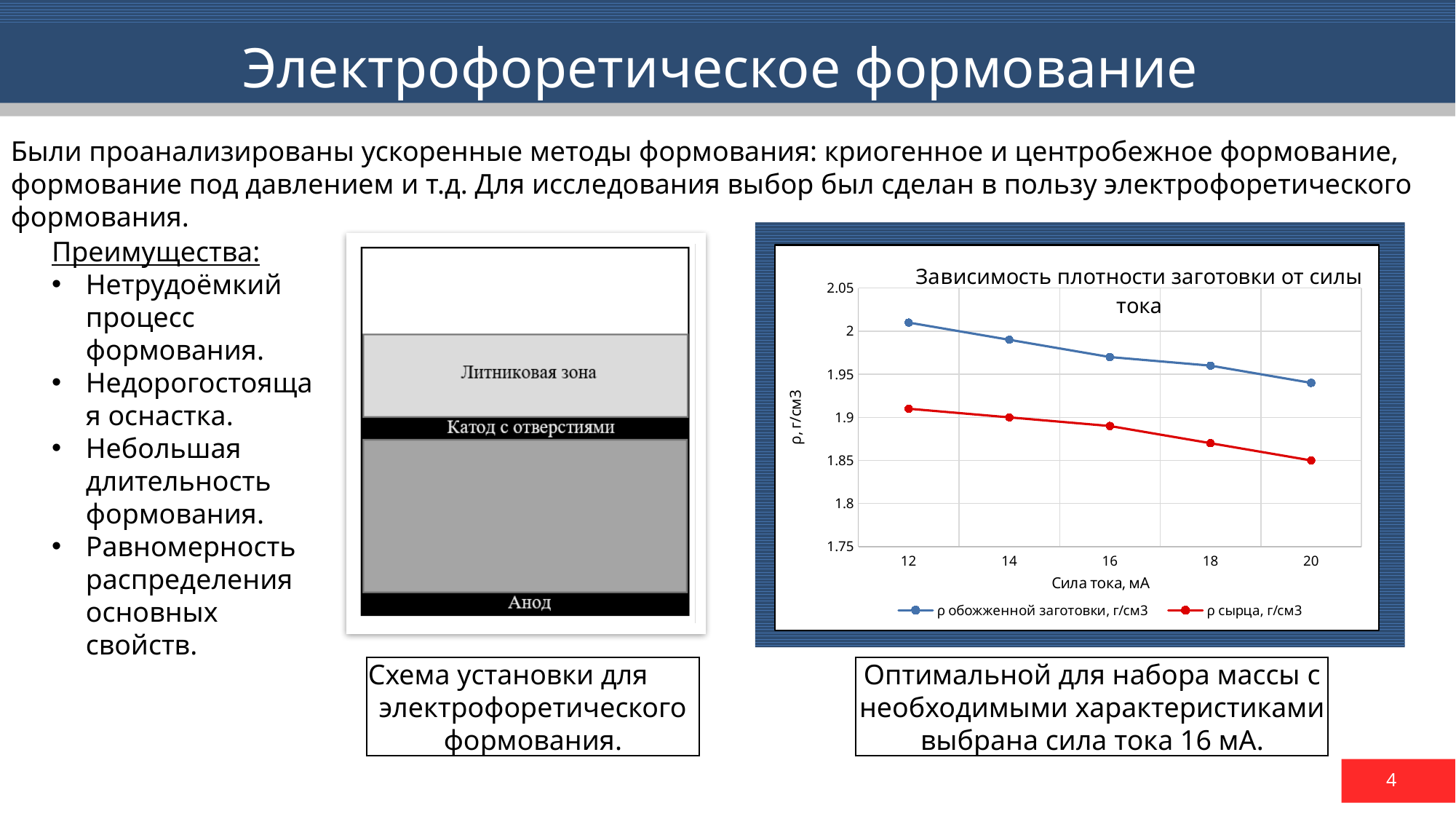
Do the values of the series 'ρ обожженной заготовки, г/см3' rise or fall as the current increases from 12 to 20 mA? fall At which current is the value of 'ρ обожженной заготовки, г/см3' highest? 12 Is the value for 'ρ обожженной заготовки, г/см3' at 14 mA greater or less than 1.95? greater Do the values of the series 'ρ сырца, г/см3' rise or fall as the current increases along the x axis? fall What is the title of the chart? Зависимость плотности заготовки от силы тока At 16 mA, which series has the larger value: 'ρ обожженной заготовки, г/см3' or 'ρ сырца, г/см3'? ρ обожженной заготовки, г/см3 How many series does the chart legend list? 2 How many current values (points) are plotted along the x axis? 5 At which current is the value of 'ρ сырца, г/см3' lowest? 20 Is the value for 'ρ сырца, г/см3' at 18 mA greater or less than 1.9? less What is the label of the x axis of the chart? Сила тока, мА What kind of chart is shown on the slide? line chart